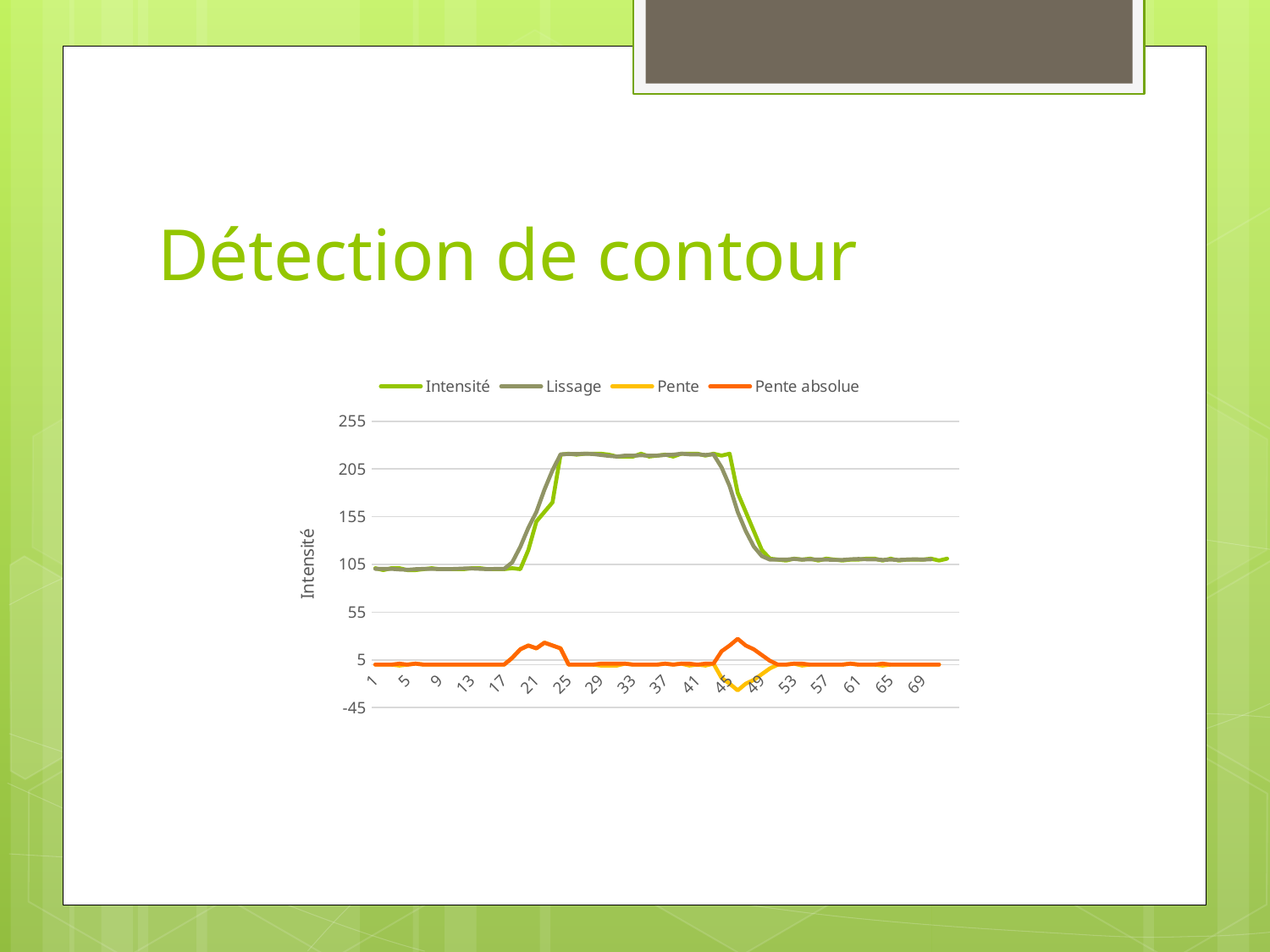
What are the series names listed in the legend? Intensité, Lissage, Pente, Pente absolue Is the value of Pente at x = 47 greater or less than 5? less What kind of chart is shown on the slide? line chart Is the value of Intensité at x = 61 greater or less than 105? greater Is the value of Intensité at x = 5 greater or less than 105? less At x = 45, which series has the larger value, Intensité or Lissage? Intensité How many series does the legend list? 4 What is the title of the vertical axis? Intensité Does the Intensité line rise or fall between x = 45 and x = 53? fall Does the Intensité line rise or fall between x = 17 and x = 25? rise